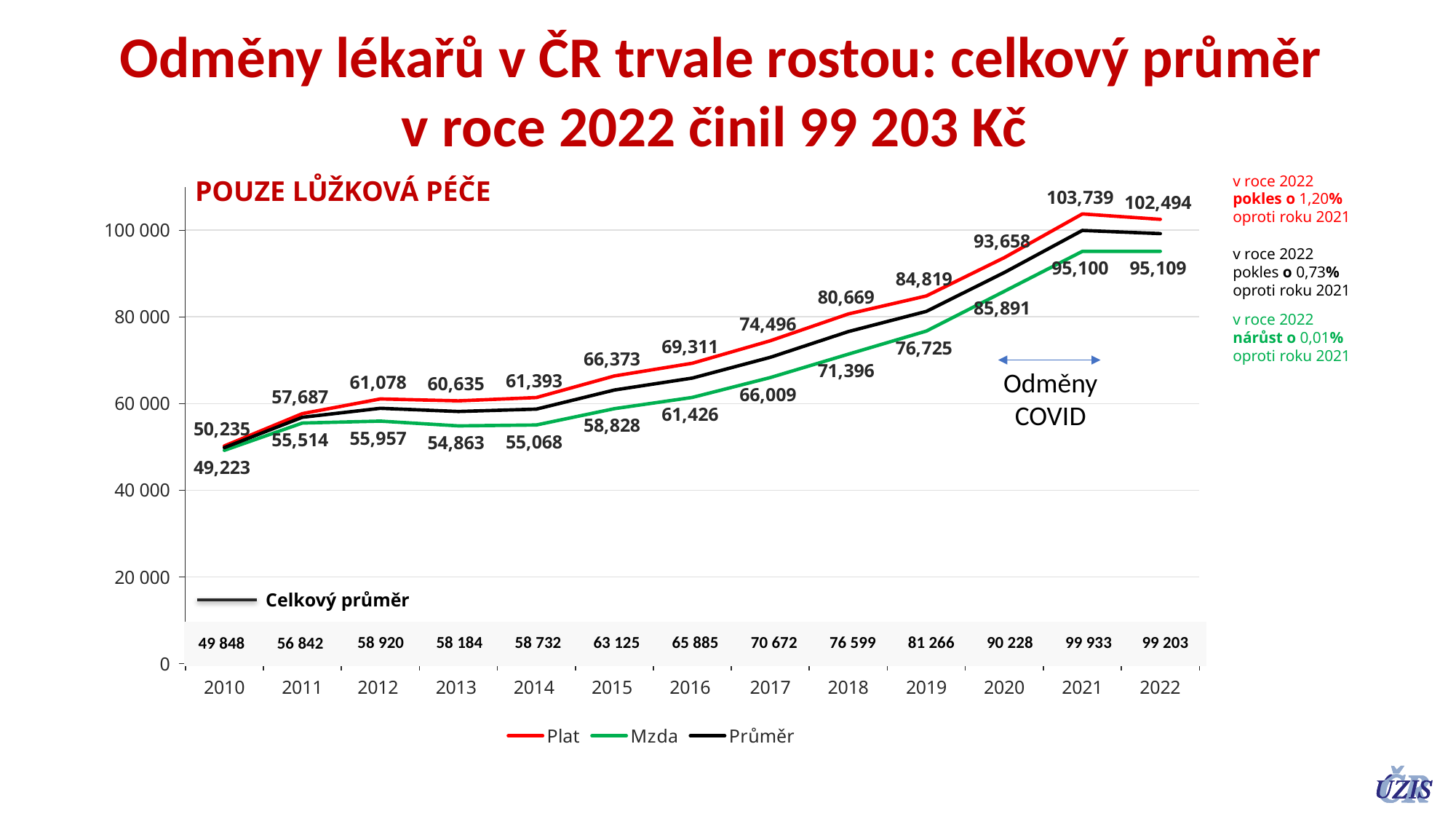
Which is larger in 2015, the Plat value or the Mzda value? Plat What is the value of the Mzda series in 2018? 71,396 How many series does the legend below the chart list? 3 Does the Mzda series rise or fall between 2014 and 2021? rise In which year is the Mzda series at its lowest value? 2010 What is the Celkový průměr value shown for 2022? 99 203 What kind of chart is shown on the slide? line chart How many years are shown on the x axis of the chart? 13 In which year does the Plat series reach its highest value? 2021 By how much did the Plat value fall from 2021 to 2022? 1,245 What is the value of the Plat series in 2021? 103,739 Is the Mzda value for 2020 greater or less than 80 000? greater